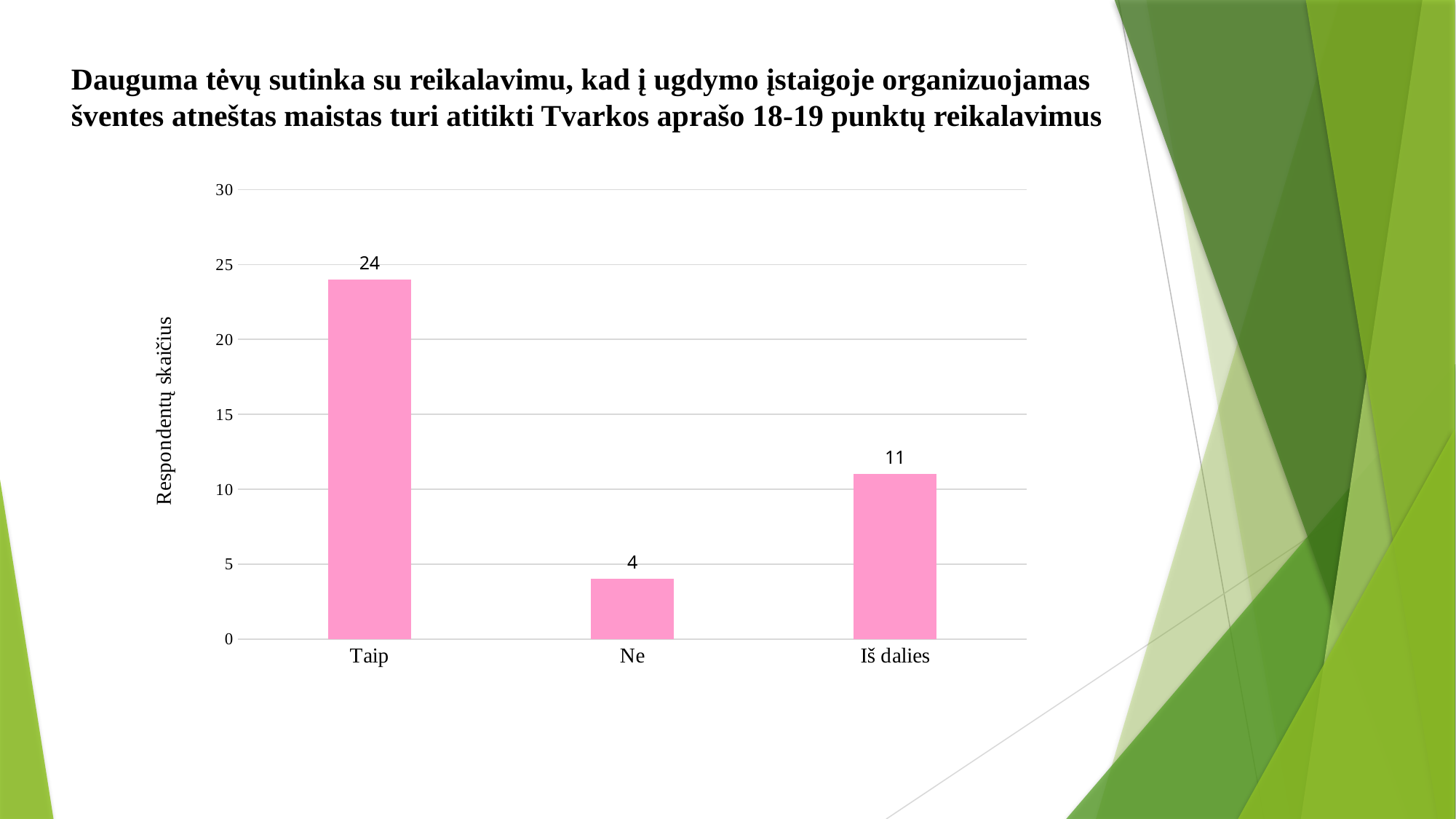
What is the difference between the values for Iš dalies and Ne? 7 What is the value for Iš dalies? 11 What is the value for Taip? 24 What is the label of the vertical axis? Respondentų skaičius Which category has the highest value? Taip What is the difference between the values for Taip and Iš dalies? 13 What kind of chart is shown on the slide? bar chart Is the value for Taip greater or less than 20? greater What is the value for Ne? 4 Which category has the lowest value? Ne How many categories are shown on the x axis? 3 Which is larger, the value for Ne or the value for Iš dalies? Iš dalies